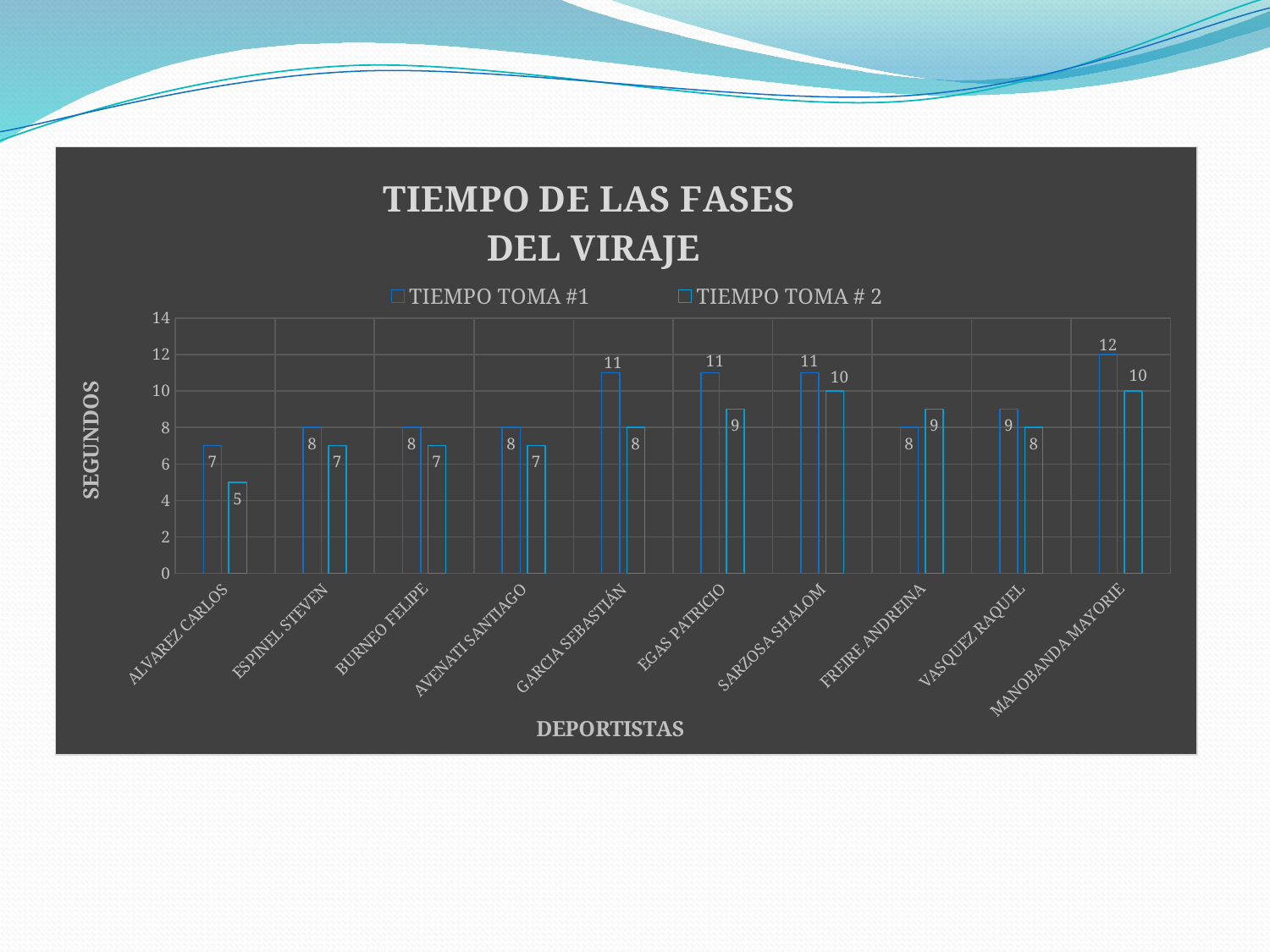
What is the difference between TIEMPO TOMA #1 and TIEMPO TOMA # 2 for GARCIA SEBASTIÁN? 3 Is the TIEMPO TOMA #1 value for SARZOSA SHALOM greater or less than 10? greater What is the difference between the TIEMPO TOMA #1 values of MANOBANDA MAYORIE and ALVAREZ CARLOS? 5 What is the TIEMPO TOMA # 2 value for FREIRE ANDREINA? 9 How many deportistas are shown on the x axis? 10 How many series does the legend list? 2 For FREIRE ANDREINA, which is larger: TIEMPO TOMA #1 or TIEMPO TOMA # 2? TIEMPO TOMA # 2 Which deportista has the lowest TIEMPO TOMA # 2 value? ALVAREZ CARLOS What is the TIEMPO TOMA # 2 value for ALVAREZ CARLOS? 5 Which deportista has the highest TIEMPO TOMA #1 value? MANOBANDA MAYORIE What kind of chart is shown on the slide? bar chart What is the TIEMPO TOMA #1 value for GARCIA SEBASTIÁN? 11